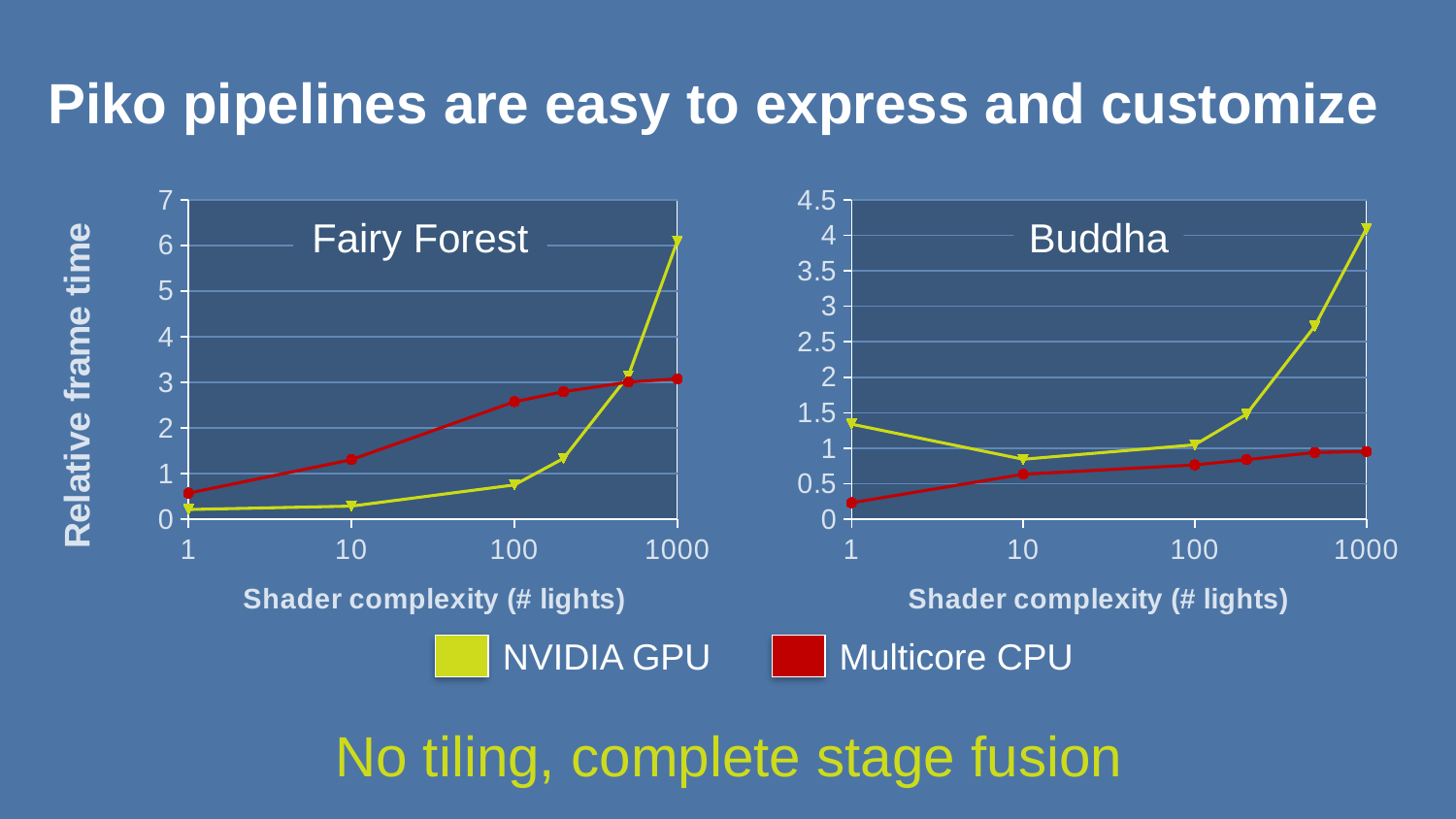
In the Fairy Forest chart, at which shader complexity does the NVIDIA GPU series reach its highest value? 1000 In the Buddha chart, at 1000 lights, which series has the larger relative frame time? NVIDIA GPU In the Fairy Forest chart, is the NVIDIA GPU value at 1000 lights greater or less than 5? greater How many series does the legend list? 2 In the Fairy Forest chart, does the Multicore CPU line rise or fall as shader complexity increases? rises In the Fairy Forest chart, at 100 lights, which series has the larger relative frame time? Multicore CPU What is the title of the chart on the right? Buddha In the Buddha chart, is the Multicore CPU value at 1 light greater or less than 0.5? less What kind of chart is the Fairy Forest chart? line chart What is the label of the y axis shared by both charts? Relative frame time In the Fairy Forest chart, is the NVIDIA GPU value at 10 lights greater or less than 1? less